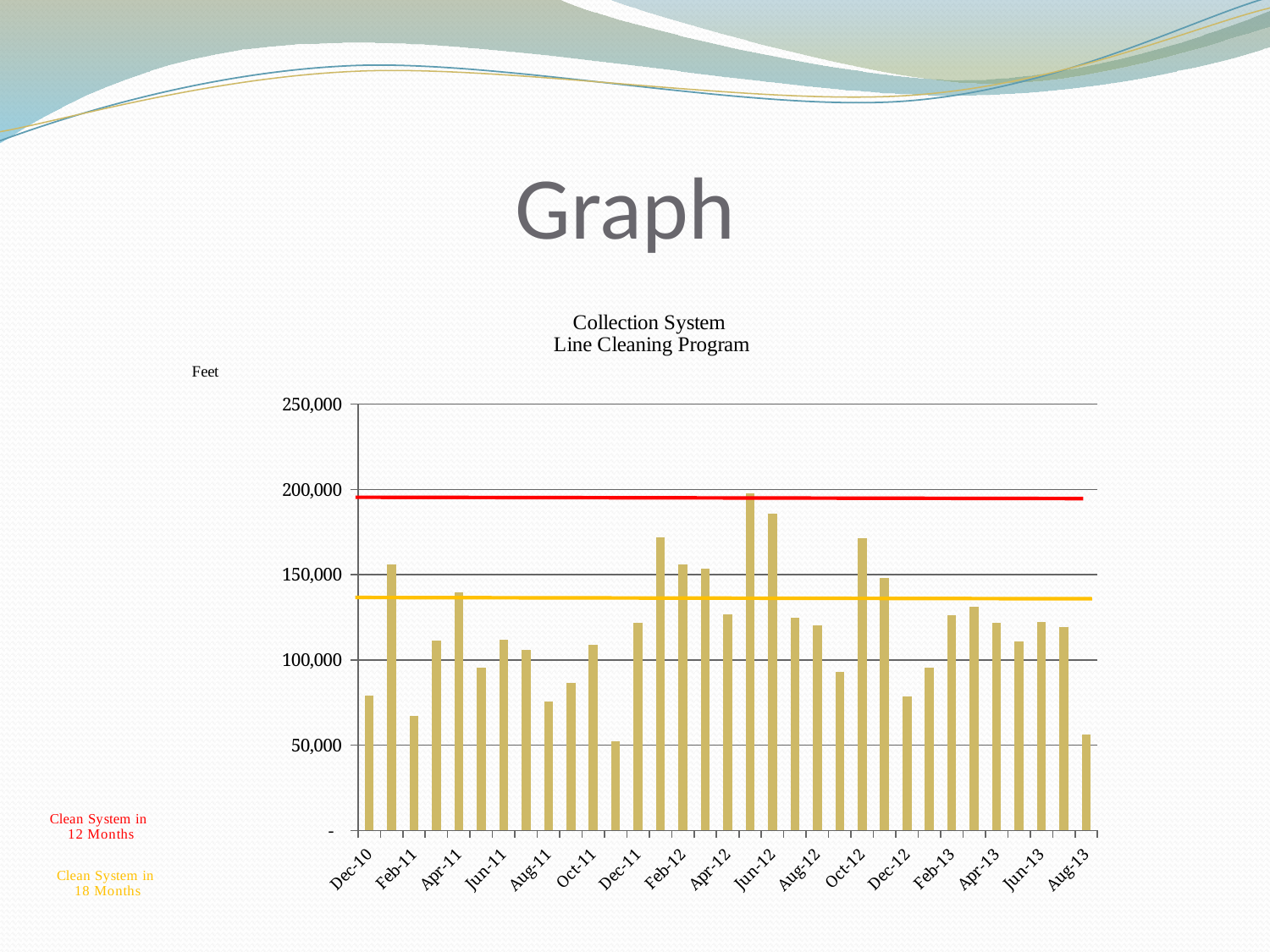
Is the value for Jun-12 greater or less than 150,000? greater What kind of chart is shown on the slide? bar chart Is the value for Oct-12 greater or less than 150,000? greater Which is larger, the value for Aug-12 or the value for Oct-12? Oct-12 What is the title of the chart? Collection System Line Cleaning Program Is the value for Dec-10 greater or less than 100,000? less How many month labels are shown along the x axis of the chart? 17 What unit is shown on the vertical axis of the chart? Feet Which is larger, the value for Feb-12 or the value for Dec-10? Feb-12